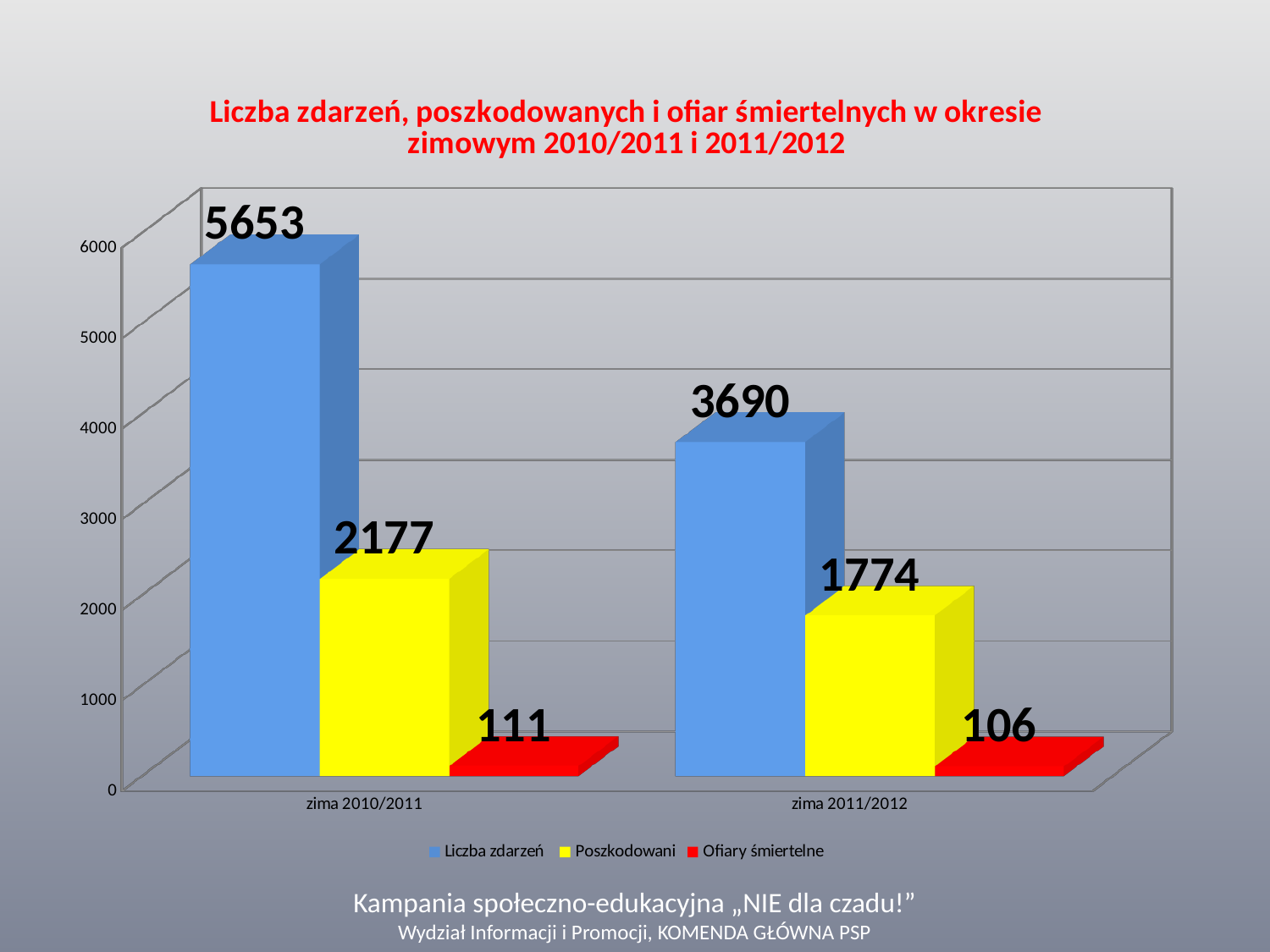
Which category has the highest value for Liczba zdarzeń? zima 2010/2011 What is the value of Poszkodowani for zima 2011/2012? 1774 What is the difference between Liczba zdarzeń for zima 2010/2011 and zima 2011/2012? 1963 Which series has the lowest value for zima 2011/2012? Ofiary śmiertelne What is the value of Liczba zdarzeń for zima 2011/2012? 3690 Which is larger: Ofiary śmiertelne for zima 2010/2011 or for zima 2011/2012? zima 2010/2011 What is the difference between Poszkodowani for zima 2010/2011 and zima 2011/2012? 403 What colour represents the Poszkodowani series? yellow What is the value of Liczba zdarzeń for zima 2010/2011? 5653 How many series does the legend list? 3 What kind of chart is shown on the slide? bar chart What is the value of Ofiary śmiertelne for zima 2010/2011? 111